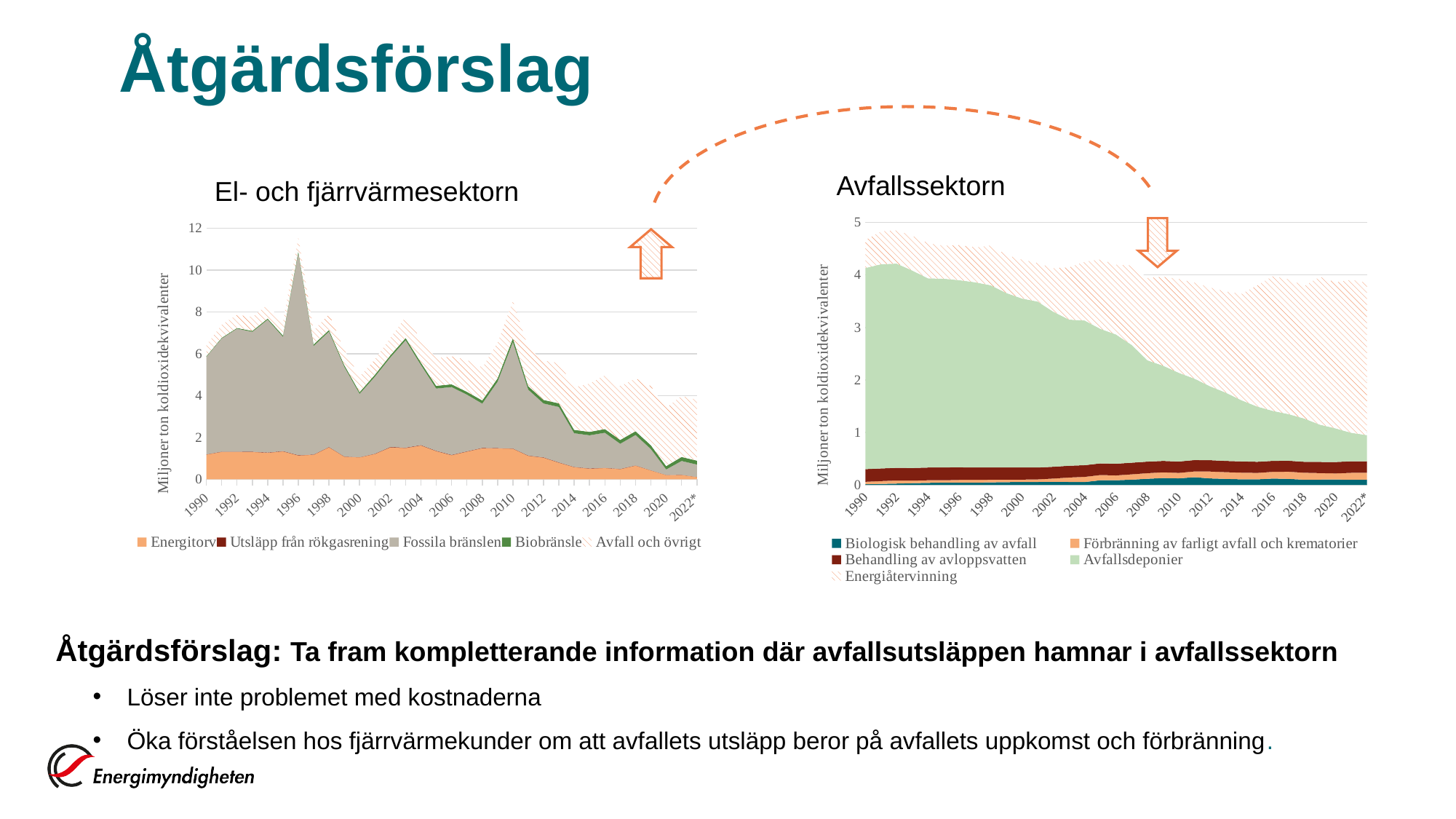
In the 'Avfallssektorn' chart, what is the y-axis title? Miljoner ton koldioxidekvivalenter In the 'Avfallssektorn' chart, is the value for 'Avfallsdeponier' in 2020 greater or less than 2? less In the 'El- och fjärrvärmesektorn' chart, which legend entry is shown with a hatched pattern? Avfall och övrigt In the 'El- och fjärrvärmesektorn' chart, is the total stacked value in 2022* greater or less than 6? less How many series does the legend of the 'El- och fjärrvärmesektorn' chart list? 5 How many series does the legend of the 'Avfallssektorn' chart list? 5 In the 'El- och fjärrvärmesektorn' chart, is the total stacked value in 1996 greater or less than 10? greater What kind of chart is the 'Avfallssektorn' chart? Stacked area chart What kind of chart is the 'El- och fjärrvärmesektorn' chart? Stacked area chart In the 'El- och fjärrvärmesektorn' chart, does the total stacked value rise or fall overall from 1990 to 2022*? Fall In the 'Avfallssektorn' chart, does the 'Avfallsdeponier' series rise or fall from 1990 to 2022*? Fall